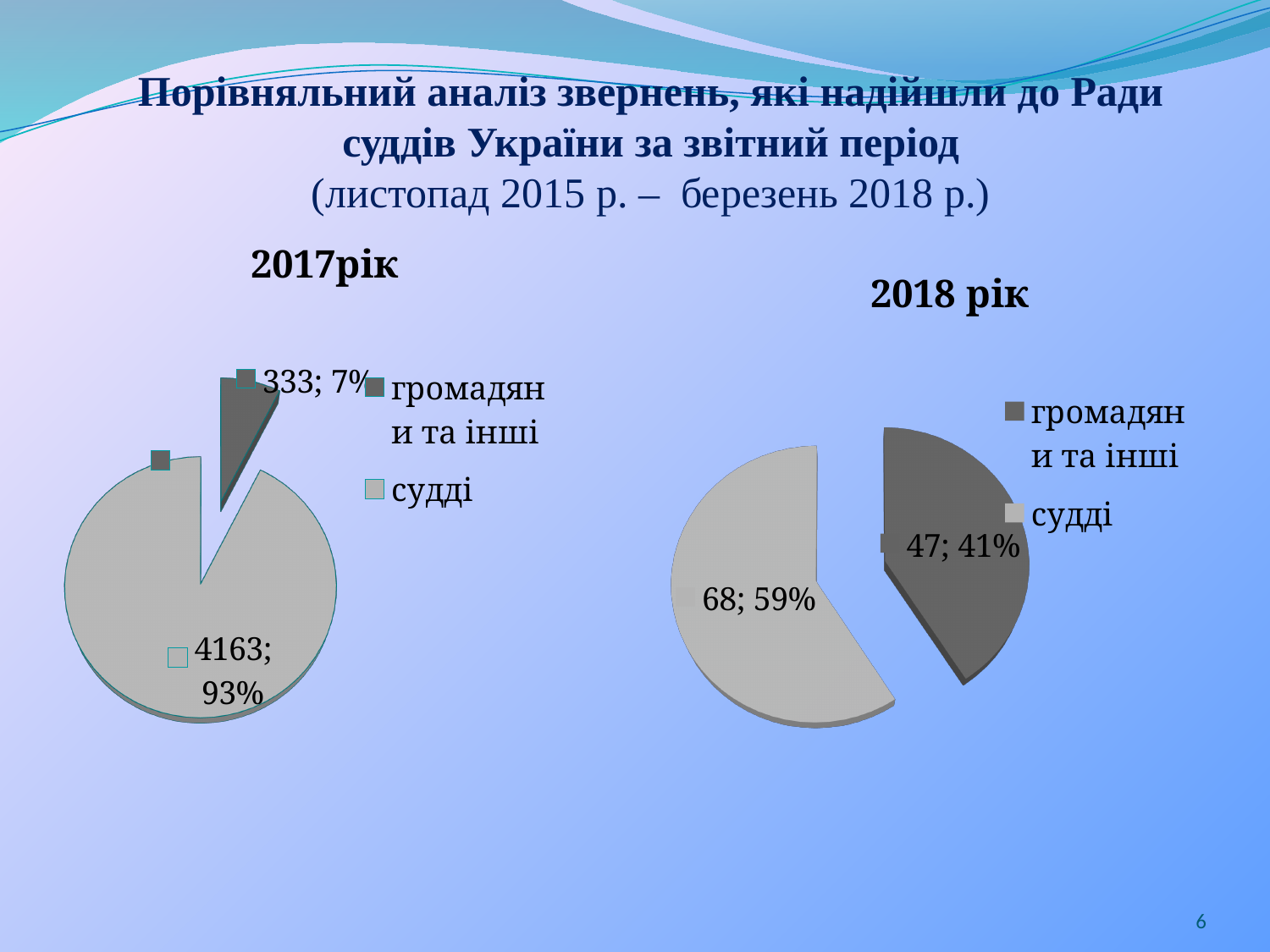
In the 2017рік chart, what share of the pie does судді take? 93% In the 2017рік chart, what value is shown for судді? 4163 In the 2017рік chart, what is the difference between the values for судді and громадяни та інші? 3830 In the 2017рік chart, what value is shown for громадяни та інші? 333 In the 2018 рік chart, what value is shown for судді? 68 How many categories does the 2017рік chart show? 2 What kind of chart is the 2018 рік chart? Pie chart In the 2018 рік chart, what share of the pie does громадяни та інші take? 41% In the 2018 рік chart, what is the difference between the values for судді and громадяни та інші? 21 In the 2018 рік chart, what value is shown for громадяни та інші? 47 In the 2017рік chart, which category is the smallest? громадяни та інші In the 2018 рік chart, which category is the largest? судді